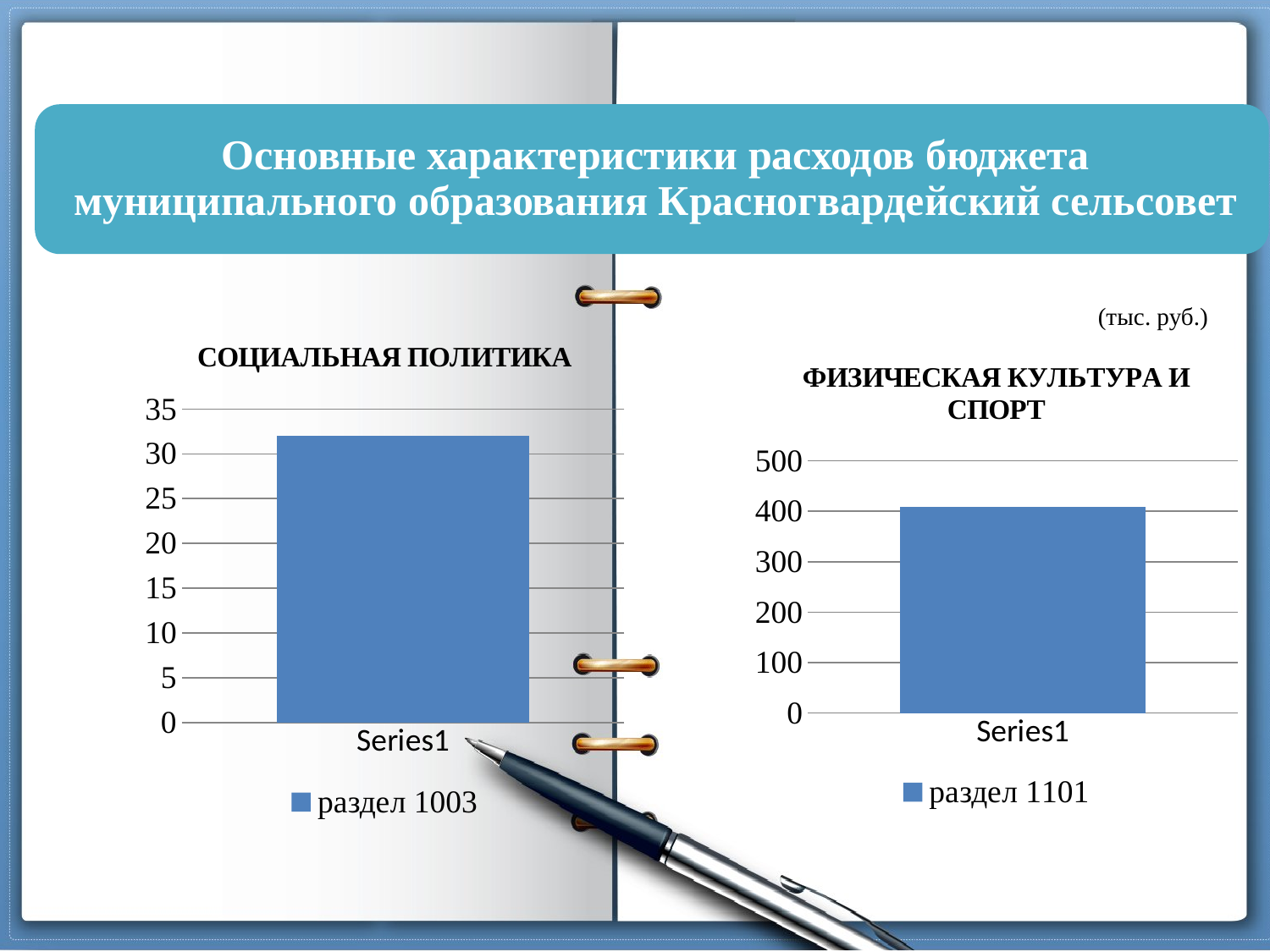
How many bars are plotted in the "ФИЗИЧЕСКАЯ КУЛЬТУРА И СПОРТ" chart? 1 What is the highest tick value on the vertical axis of the "ФИЗИЧЕСКАЯ КУЛЬТУРА И СПОРТ" chart? 500 How many series does the legend of the "СОЦИАЛЬНАЯ ПОЛИТИКА" chart list? 1 In the "СОЦИАЛЬНАЯ ПОЛИТИКА" chart, is the value for Series1 greater or less than 30? greater How many bars are plotted in the "СОЦИАЛЬНАЯ ПОЛИТИКА" chart? 1 What is the legend entry of the "СОЦИАЛЬНАЯ ПОЛИТИКА" chart? раздел 1003 What is the legend entry of the "ФИЗИЧЕСКАЯ КУЛЬТУРА И СПОРТ" chart? раздел 1101 What kind of chart is the "ФИЗИЧЕСКАЯ КУЛЬТУРА И СПОРТ" chart? bar chart In the "СОЦИАЛЬНАЯ ПОЛИТИКА" chart, is the value for Series1 greater or less than 35? less In the "ФИЗИЧЕСКАЯ КУЛЬТУРА И СПОРТ" chart, is the value for Series1 greater or less than 500? less What kind of chart is the "СОЦИАЛЬНАЯ ПОЛИТИКА" chart? bar chart